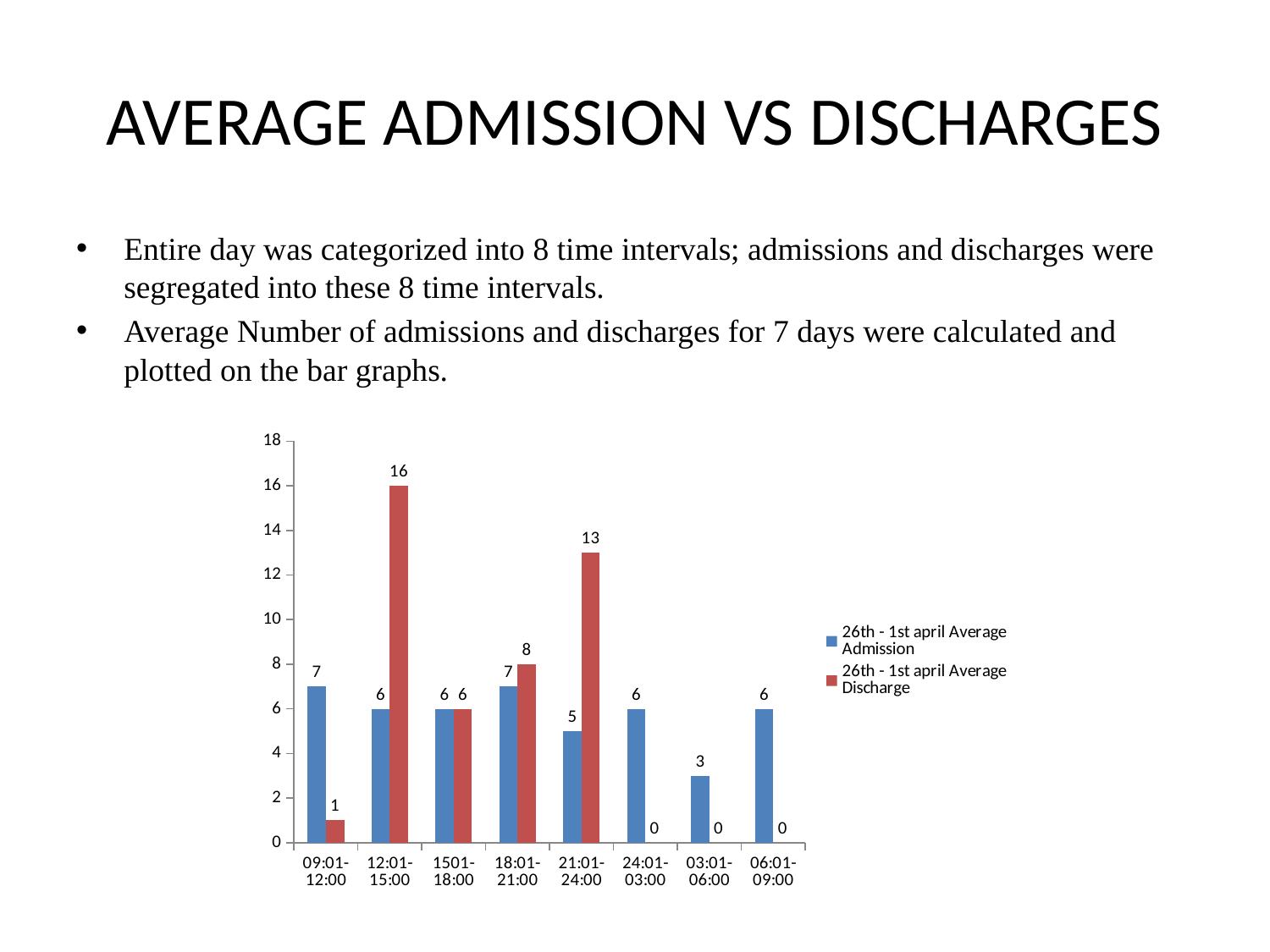
Which time interval has the highest average discharge? 12:01-15:00 What is the average discharge value for the 12:01-15:00 interval? 16 In the 18:01-21:00 interval, which is larger: average admission or average discharge? Average discharge How many series does the legend list? 2 What is the average admission value for the 03:01-06:00 interval? 3 What is the average admission value for the 09:01-12:00 interval? 7 What is the average discharge value for the 21:01-24:00 interval? 13 How many time intervals have an average discharge of 0? 3 How many time intervals are shown on the x axis? 8 What is the difference between average discharge and average admission in the 12:01-15:00 interval? 10 What kind of chart is shown on the slide? Bar chart Which time interval has the lowest average admission? 03:01-06:00